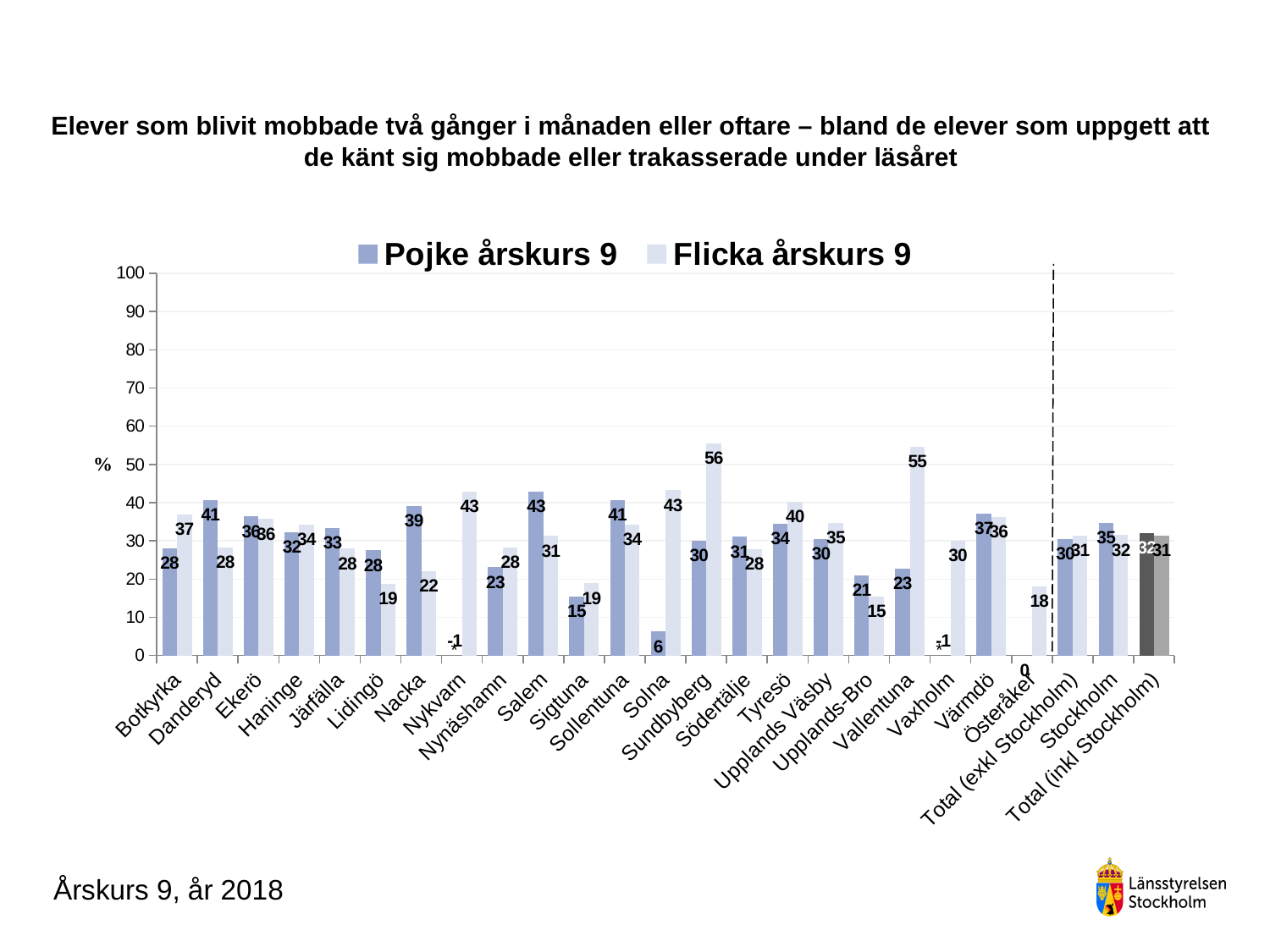
What kind of chart is shown on the slide? Bar chart Which is larger in Nacka: the Pojke årskurs 9 value or the Flicka årskurs 9 value? Pojke årskurs 9 Is the value for Flicka årskurs 9 in Solna greater or less than 40? greater What is the value for Flicka årskurs 9 in Vallentuna? 55 What is the difference between the Flicka årskurs 9 and Pojke årskurs 9 values in Vallentuna? 32 What is the value for Pojke årskurs 9 in Danderyd? 41 What is the value for Pojke årskurs 9 in Stockholm? 35 What unit is shown on the y axis? % What is the value for Flicka årskurs 9 in Sundbyberg? 56 Which municipality has the highest value for Pojke årskurs 9? Salem How many series does the legend list? 2 Which municipality has the highest value for Flicka årskurs 9? Sundbyberg